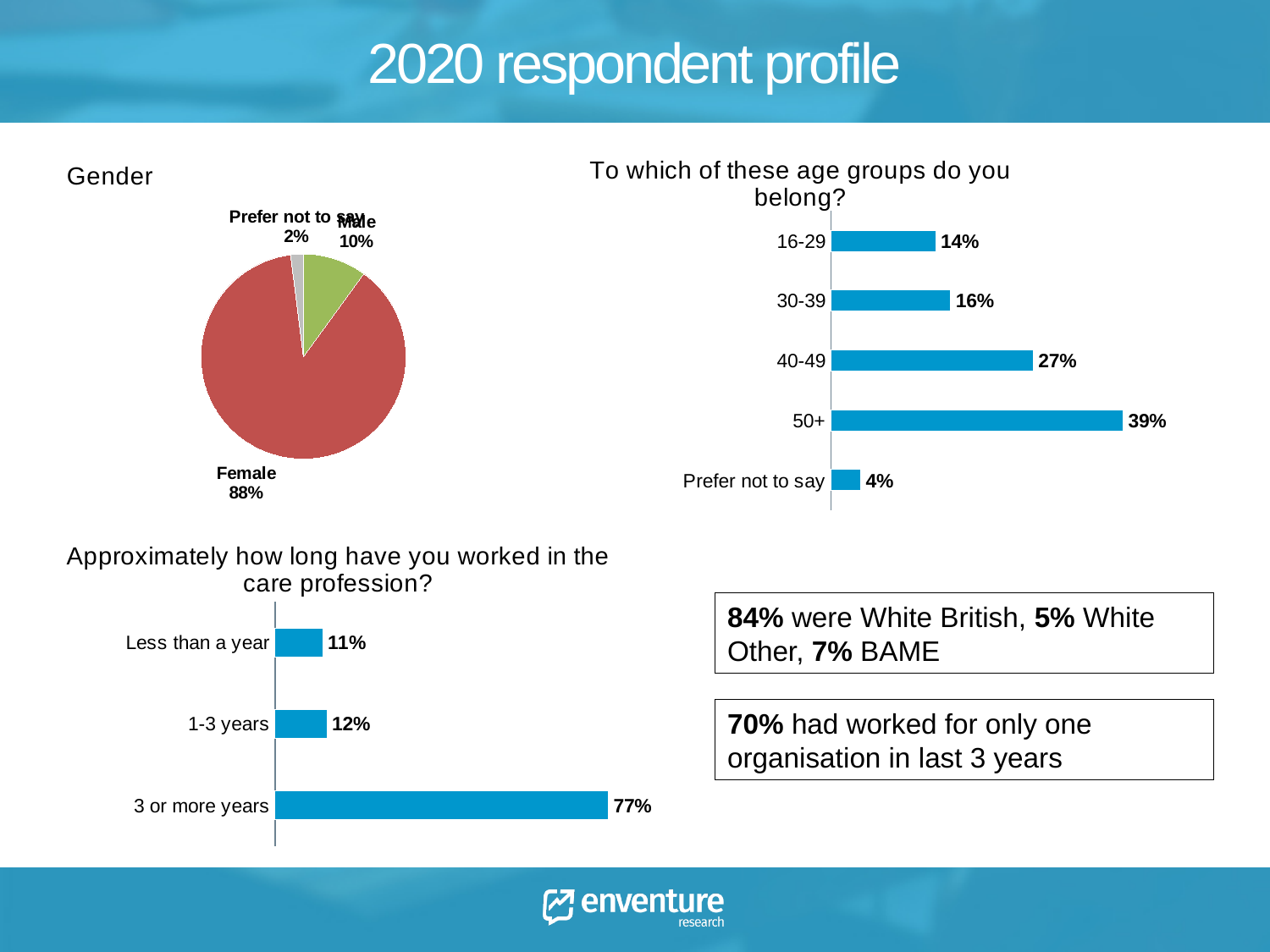
In the age groups chart, what is the difference between the values for 50+ and 16-29? 25% In the care profession chart, what is the value for 3 or more years? 77% In the age groups chart, which category has the lowest value? Prefer not to say In the age groups chart, what is the value for 40-49? 27% What kind of chart is the Gender chart? Pie chart In the age groups chart, which age group has the highest value? 50+ What kind of chart is the care profession chart? Bar chart In the Gender pie chart, what share of respondents were Male? 10% In the age groups chart, how many categories are shown? 5 In the Gender pie chart, how many slices are there? 3 In the Gender pie chart, what share of respondents were Female? 88% In the care profession chart, which is larger: Less than a year or 1-3 years? 1-3 years